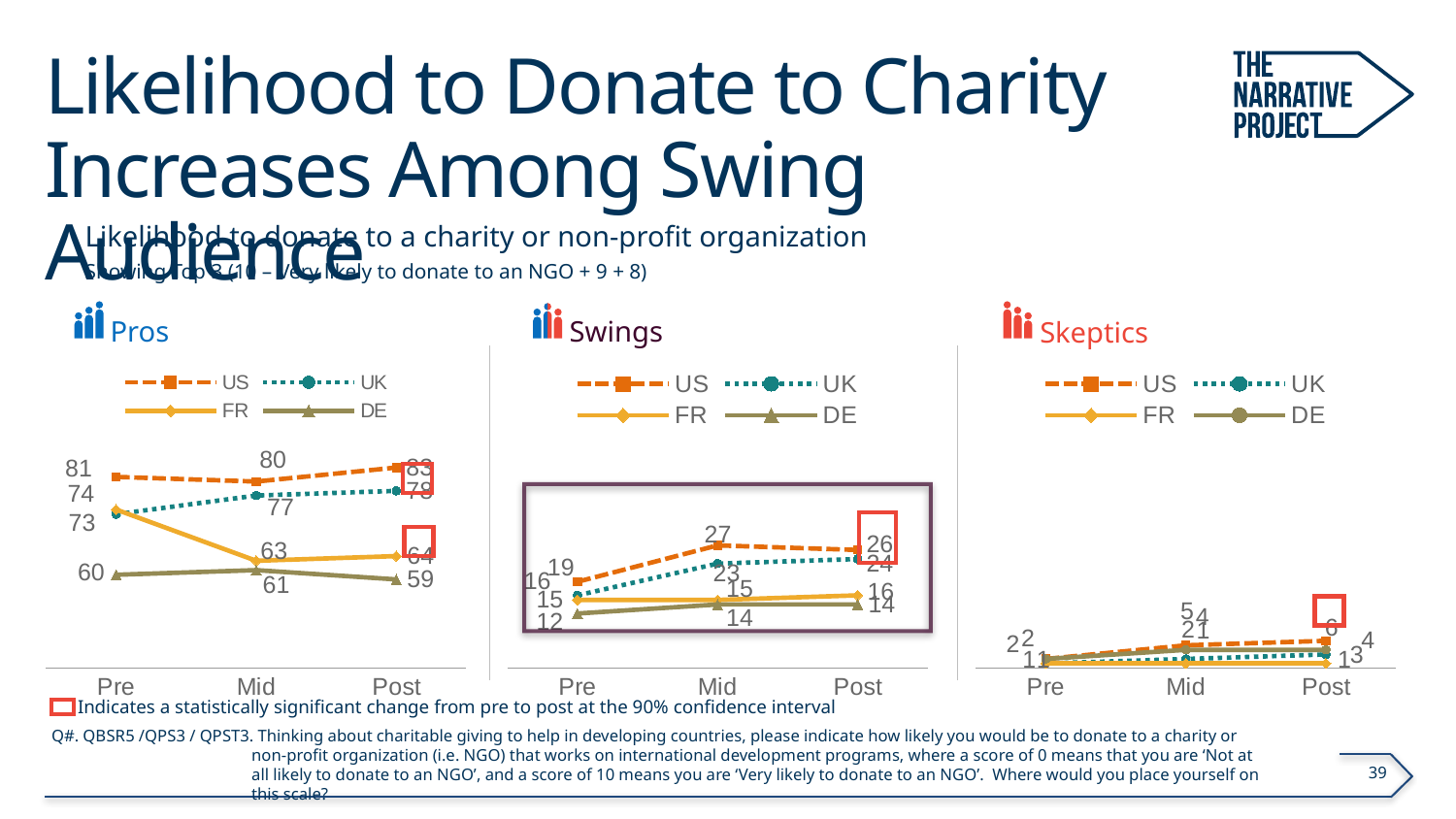
In the Swings chart, what is the difference between the US and DE values at Mid? 13 How many points are on the x axis of the Skeptics chart? 3 In the Pros chart, does the FR line rise or fall from Pre to Mid? fall In the Swings chart, what is the DE value at Pre? 12 In the Pros chart, what is the DE value at Pre? 60 In the Swings chart, what is the UK value at Post? 24 What kind of chart is the Swings chart? line chart In the Pros chart, which series has the lowest value at Pre? DE In the Swings chart, what is the US value at Mid? 27 In the Skeptics chart, what is the US value at Post? 6 In the Pros chart, what is the US value at Pre? 81 How many series does the legend of the Pros chart list? 4